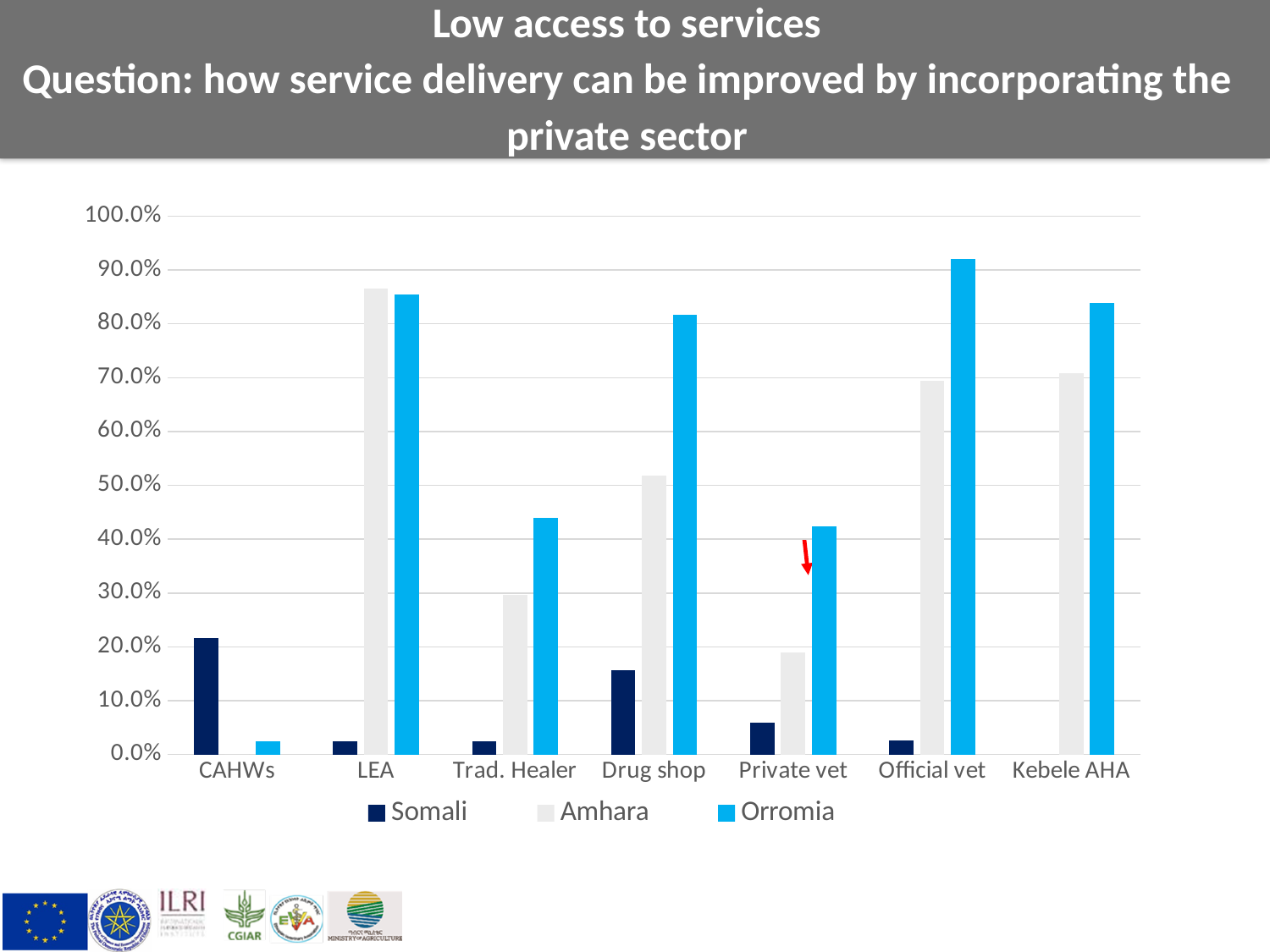
Is the Amhara value for Trad. Healer greater or less than 40.0%? less Is the Somali value for CAHWs greater or less than 10.0%? greater How many series does the chart's legend list? 3 Which category has the lowest value for the Orromia series? CAHWs What kind of chart is shown on the slide? bar chart How many categories are shown on the x axis of the chart? 7 Which category has the highest value for the Amhara series? LEA For Drug shop, which series has the larger value, Amhara or Orromia? Orromia Which series is shown in light blue in the chart's legend? Orromia Is the Orromia value for Official vet greater or less than 90.0%? greater Which category has the highest value for the Orromia series? Official vet Which category has the highest value for the Somali series? CAHWs